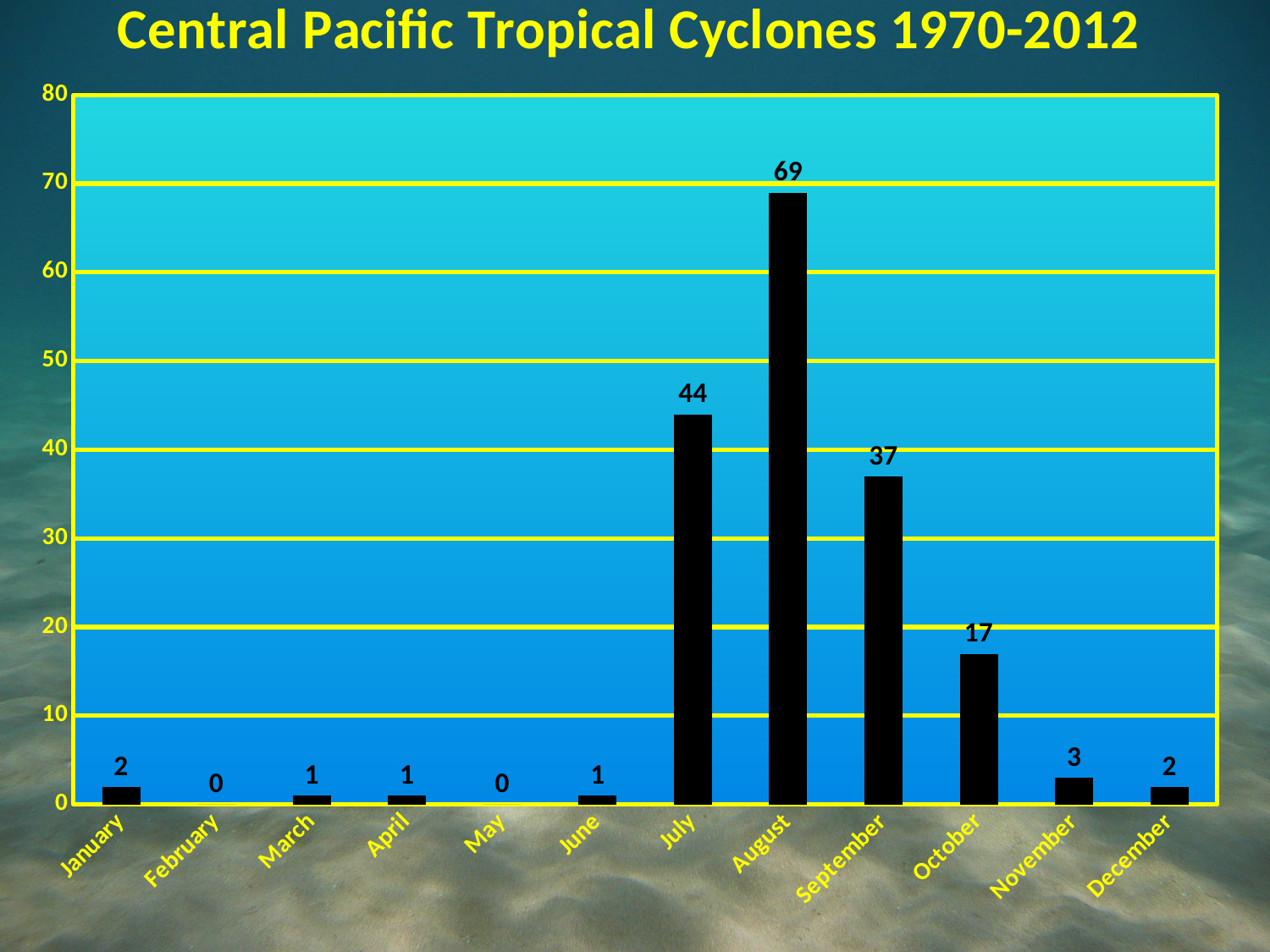
What kind of chart is shown on the slide? bar chart Which is larger, the value for September or the value for July? July Which months have a value of 0? February and May What is the difference between the values for August and September? 32 What is the value for October? 17 Is the value for September greater or less than 40? less What is the value for August? 69 What is the title of the chart? Central Pacific Tropical Cyclones 1970-2012 Which month has the highest value? August What is the value for July? 44 How many months are shown on the x axis? 12 What is the difference between the values for July and October? 27